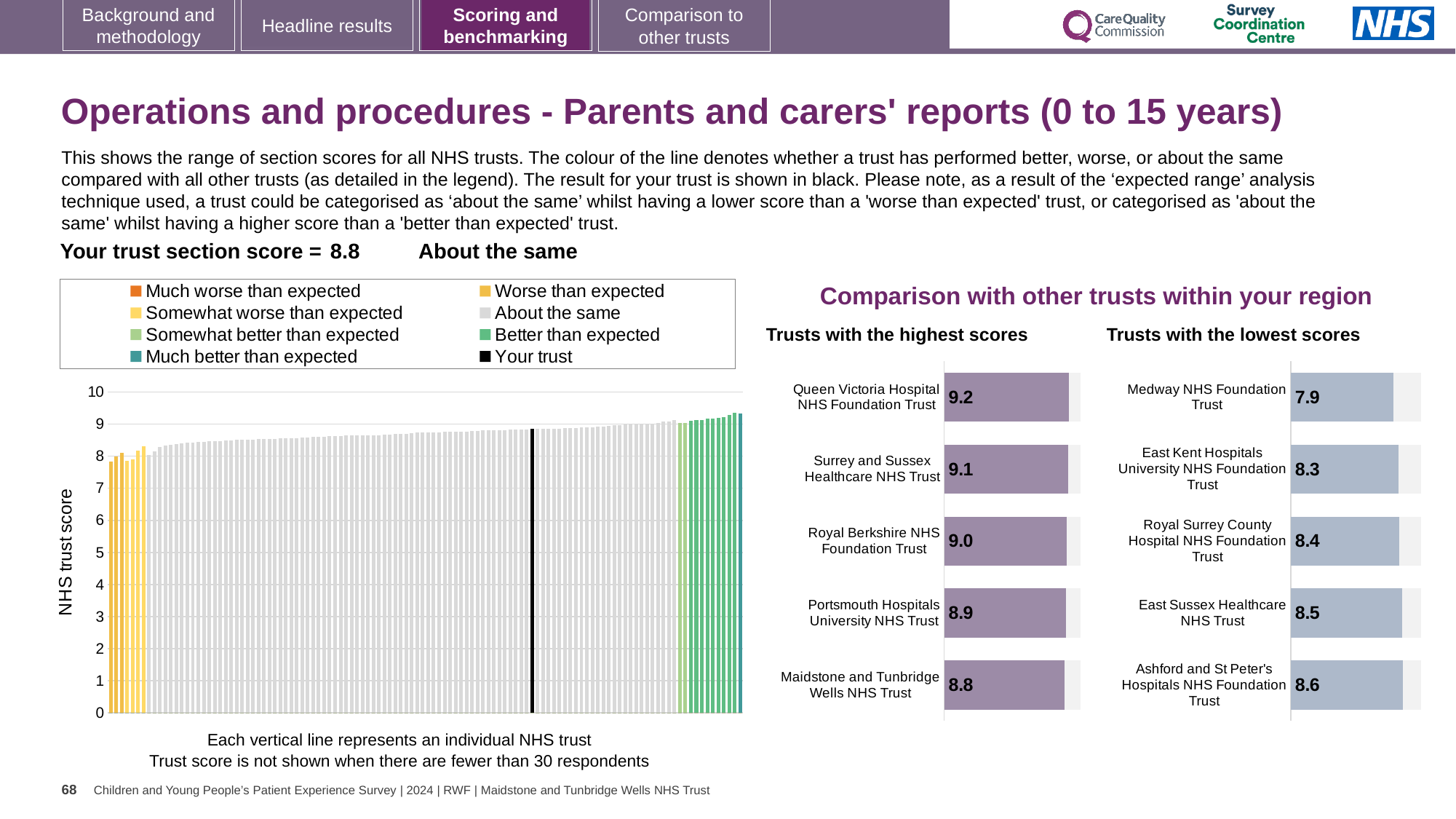
How many trusts are shown in the 'Trusts with the lowest scores' chart? 5 In the 'Trusts with the lowest scores' chart, which has the larger score: East Kent Hospitals University NHS Foundation Trust or East Sussex Healthcare NHS Trust? East Sussex Healthcare NHS Trust What type of chart is the large chart on the left showing NHS trust scores? Bar chart In the 'Trusts with the lowest scores' chart, what is the score for Medway NHS Foundation Trust? 7.9 In the 'Trusts with the highest scores' chart, which trust has the lowest score? Maidstone and Tunbridge Wells NHS Trust What is the section score for your trust shown on the slide? 8.8 In the 'Trusts with the highest scores' chart, what is the score for Queen Victoria Hospital NHS Foundation Trust? 9.2 In the 'Trusts with the highest scores' chart, what is the difference between the scores of Queen Victoria Hospital NHS Foundation Trust and Portsmouth Hospitals University NHS Trust? 0.3 How many entries does the legend above the large chart on the left list? 8 In the large chart on the left, do the trust scores rise or fall from left to right? Rise In the 'Trusts with the lowest scores' chart, which trust has the highest score? Ashford and St Peter's Hospitals NHS Foundation Trust In the 'Trusts with the lowest scores' chart, what is the score for Royal Surrey County Hospital NHS Foundation Trust? 8.4